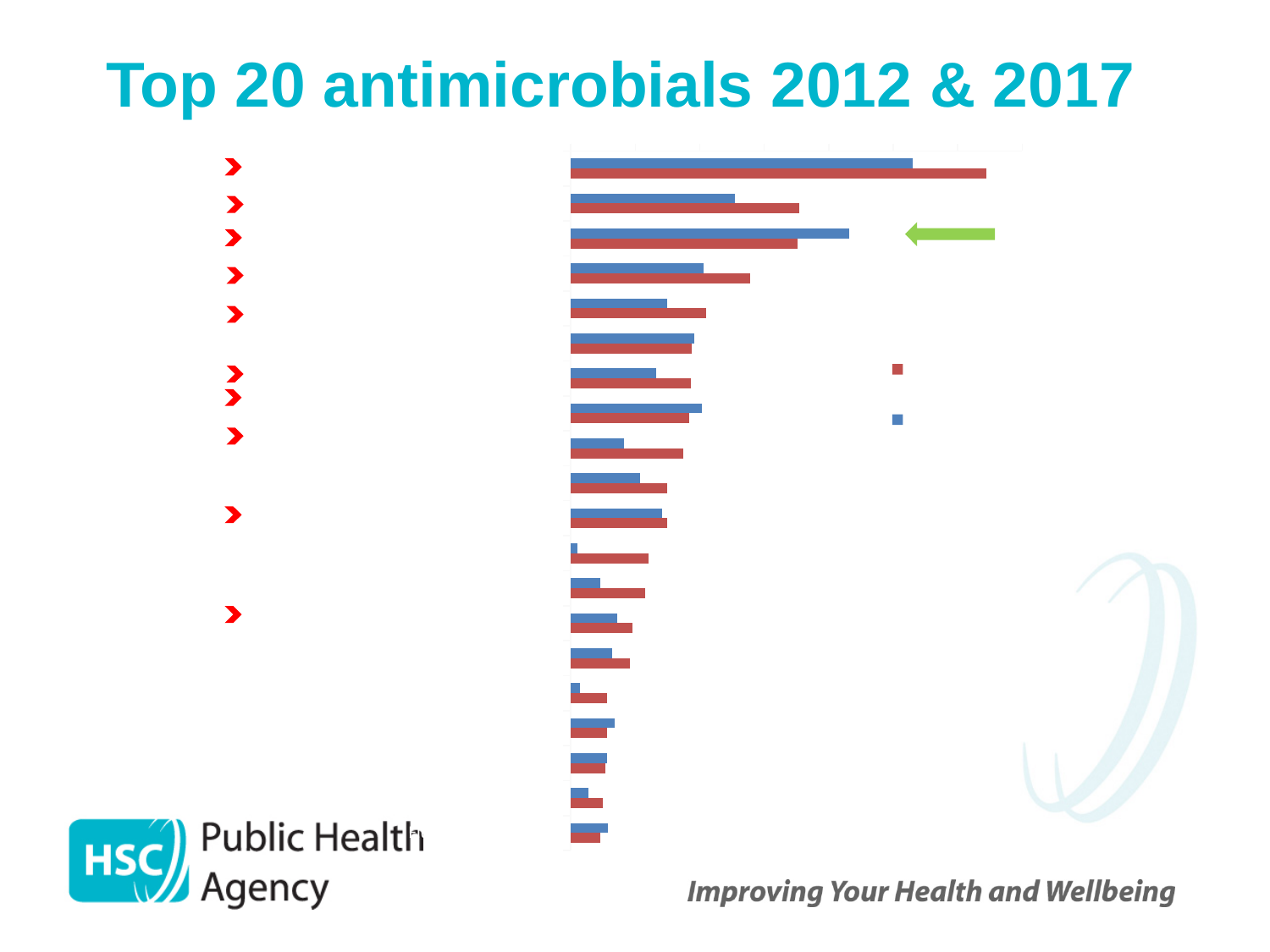
How many series does the chart's legend list? 2 What kind of chart is shown on the slide? bar chart For the topmost row of bars, which bar is longer, the blue one or the red one? red How many categories (rows of bars) does the chart show? 20 Which row of bars has the longest bars in the chart? the topmost row Do the bar lengths generally increase or decrease going from the top of the chart to the bottom? decrease For the row marked with the green arrow (third from the top), which bar is longer, the blue one or the red one? blue What is the title of the slide containing the chart? Top 20 antimicrobials 2012 & 2017 What two colours are used for the bars in the chart? blue and red